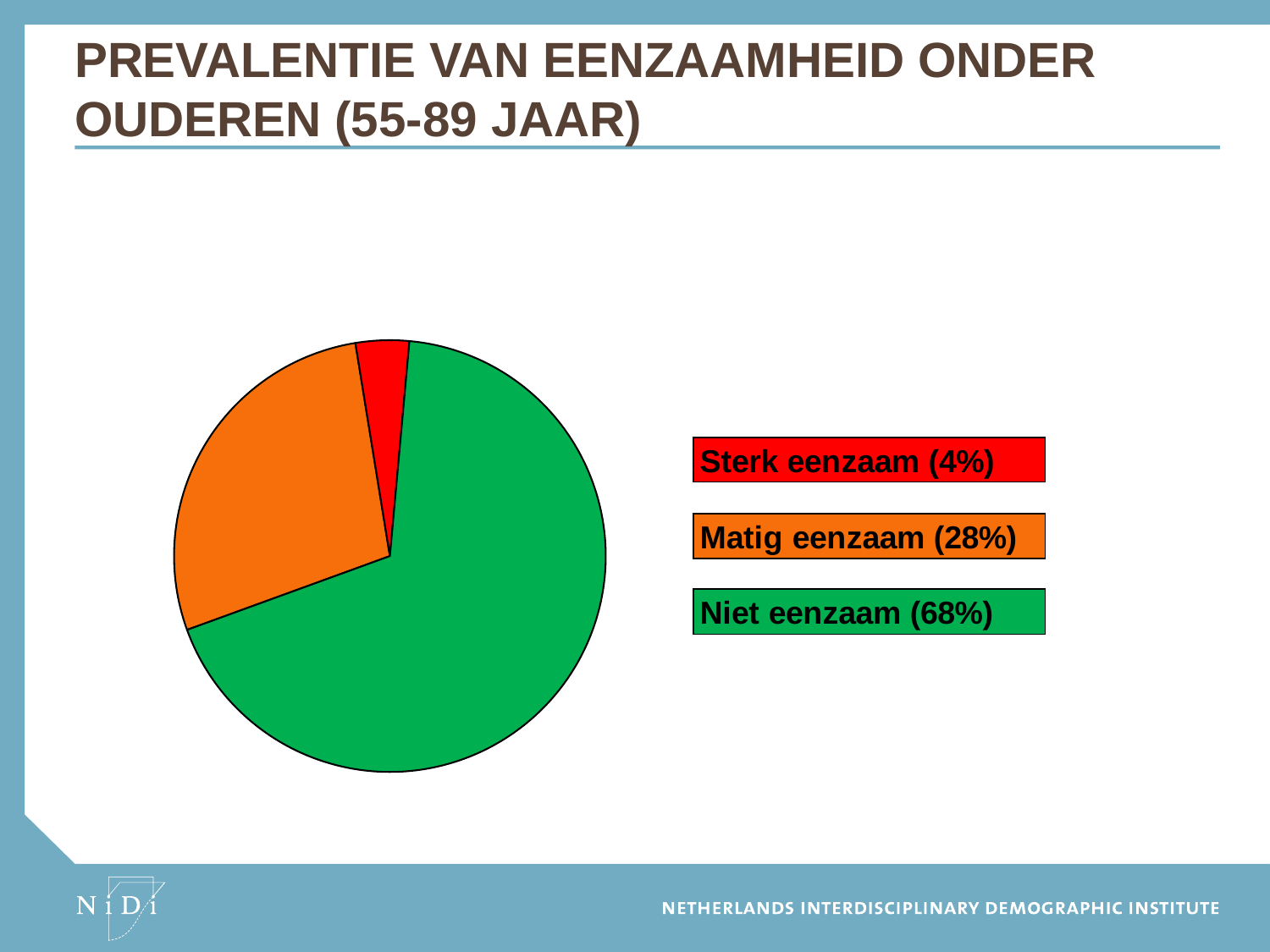
Which is larger, the share for Matig eenzaam or the share for Sterk eenzaam? Matig eenzaam What percentage is shown for Niet eenzaam? 68% What is the title of the slide containing the pie chart? PREVALENTIE VAN EENZAAMHEID ONDER OUDEREN (55-89 JAAR) What is the difference in percentage points between Niet eenzaam and Matig eenzaam? 40 What kind of chart is shown on the slide? pie chart Which category has the largest share of the pie? Niet eenzaam How many slices does the pie chart have? 3 What percentage is shown for Sterk eenzaam? 4% What colour is the slice for Niet eenzaam? green Which category has the smallest share of the pie? Sterk eenzaam What is the difference in percentage points between Matig eenzaam and Sterk eenzaam? 24 What percentage is shown for Matig eenzaam? 28%